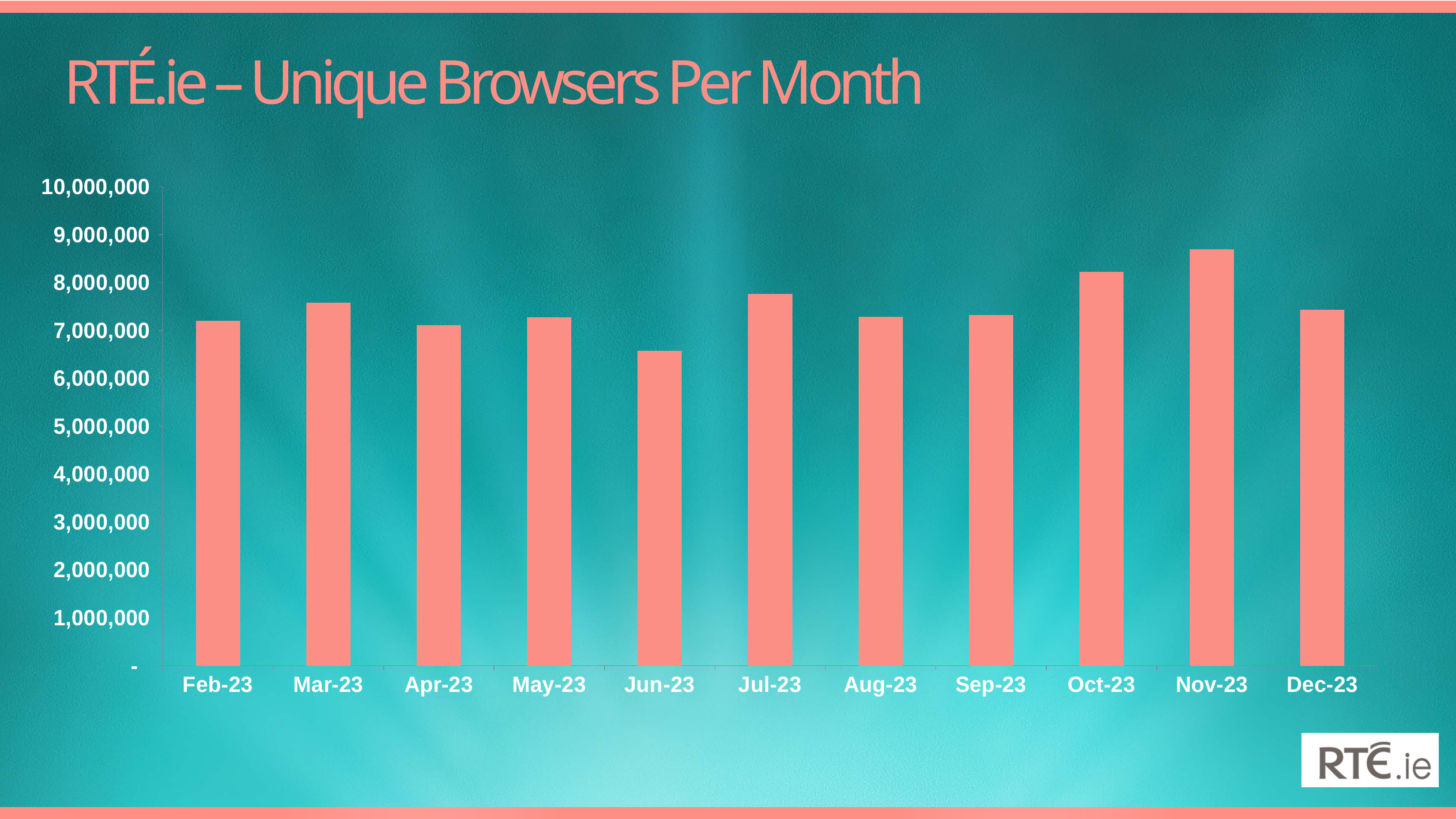
Is the value for Jun-23 greater or less than 7,000,000? less Which month has the highest number of unique browsers? Nov-23 What kind of chart is shown on the slide? Bar chart Is the value for Jul-23 greater or less than 8,000,000? less Is the value for Nov-23 greater or less than 8,000,000? greater Which is larger, the value for Mar-23 or Apr-23? Mar-23 What is the highest value shown on the vertical axis? 10,000,000 Which month has the lowest number of unique browsers? Jun-23 How many months are plotted on the chart? 11 What is the title of the chart? RTÉ.ie – Unique Browsers Per Month Which is larger, the value for Oct-23 or Nov-23? Nov-23